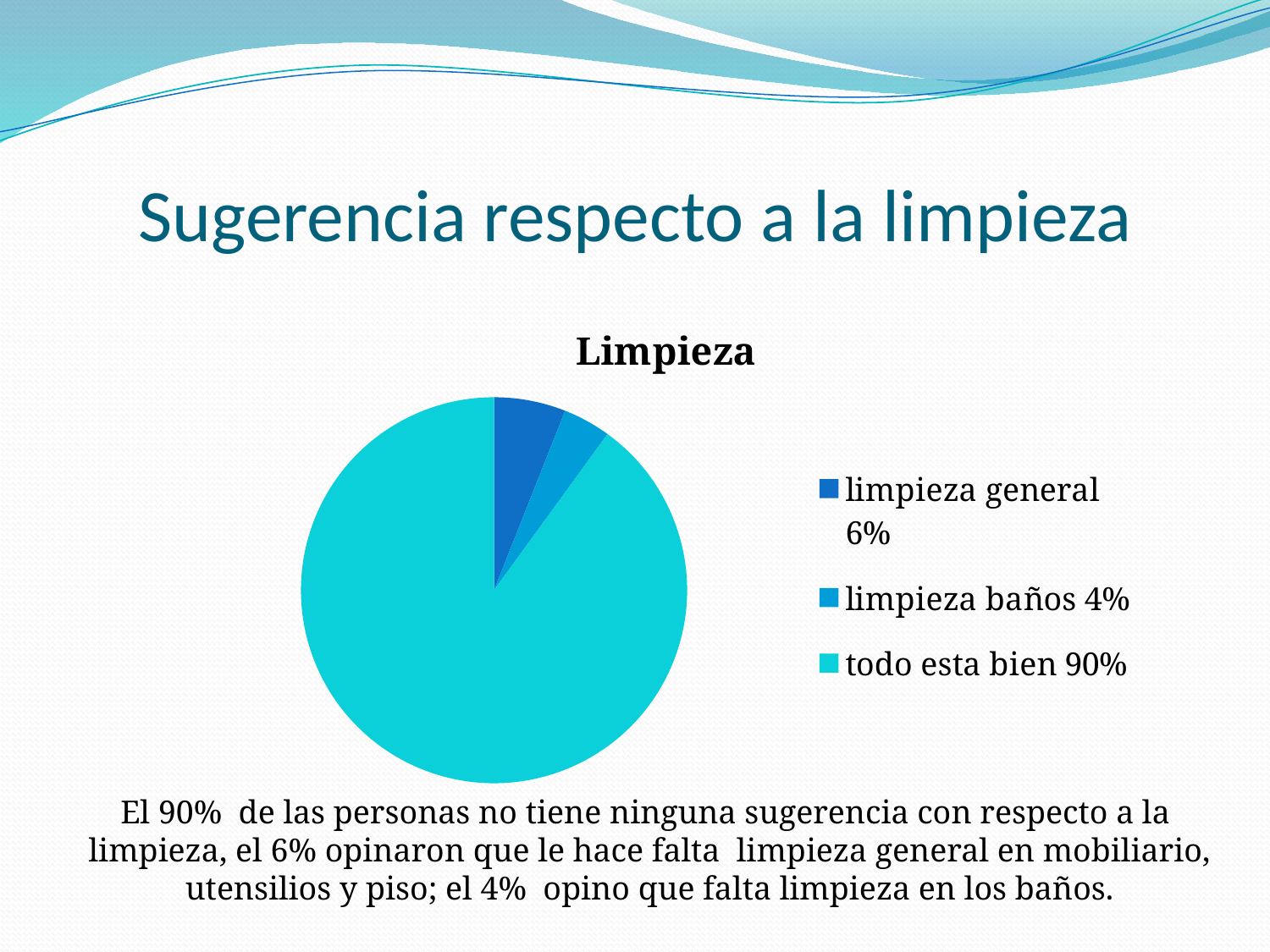
What share of the pie does 'todo esta bien' represent? 90% Which is larger, the slice for 'limpieza general' or the slice for 'limpieza baños'? limpieza general What is the difference in percentage points between 'todo esta bien' and 'limpieza general'? 84 How many entries does the legend list? 3 What kind of chart is shown on the slide? pie chart Which category has the largest slice of the pie? todo esta bien What share of the pie does 'limpieza baños' represent? 4% What share of the pie does 'limpieza general' represent? 6% What is the title of the chart? Limpieza How many slices does the pie chart have? 3 Which category has the smallest slice of the pie? limpieza baños What is the difference in percentage points between 'limpieza general' and 'limpieza baños'? 2